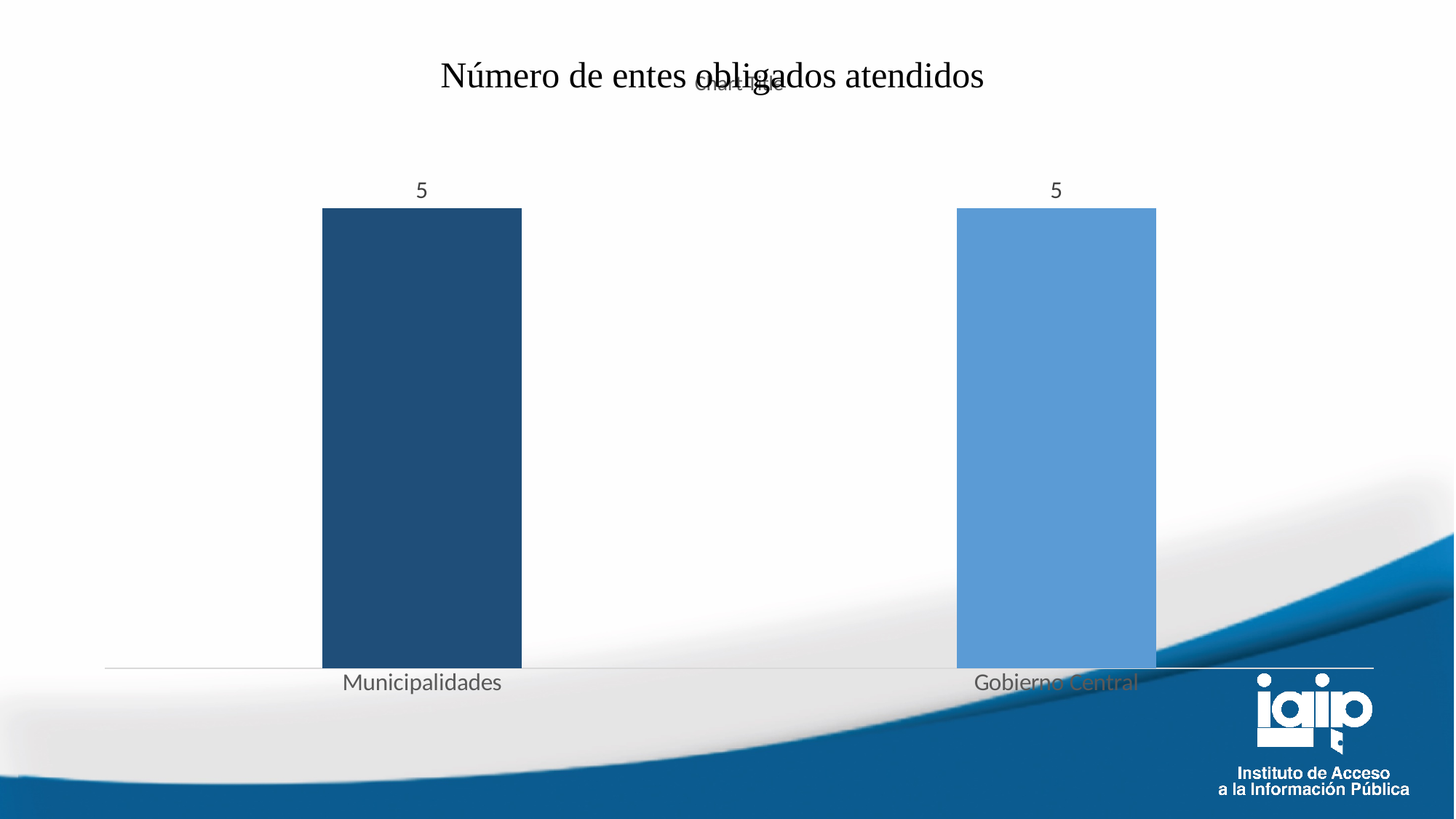
How many categories are shown on the x axis? 2 What is the title of the chart? Número de entes obligados atendidos What is the value for Gobierno Central? 5 Do the values rise, fall or stay the same from Municipalidades to Gobierno Central? Stay the same What is the difference between the values for Municipalidades and Gobierno Central? 0 What kind of chart is shown on the slide? Bar chart What is the value for Municipalidades? 5 Which category is shown with the lighter blue bar? Gobierno Central